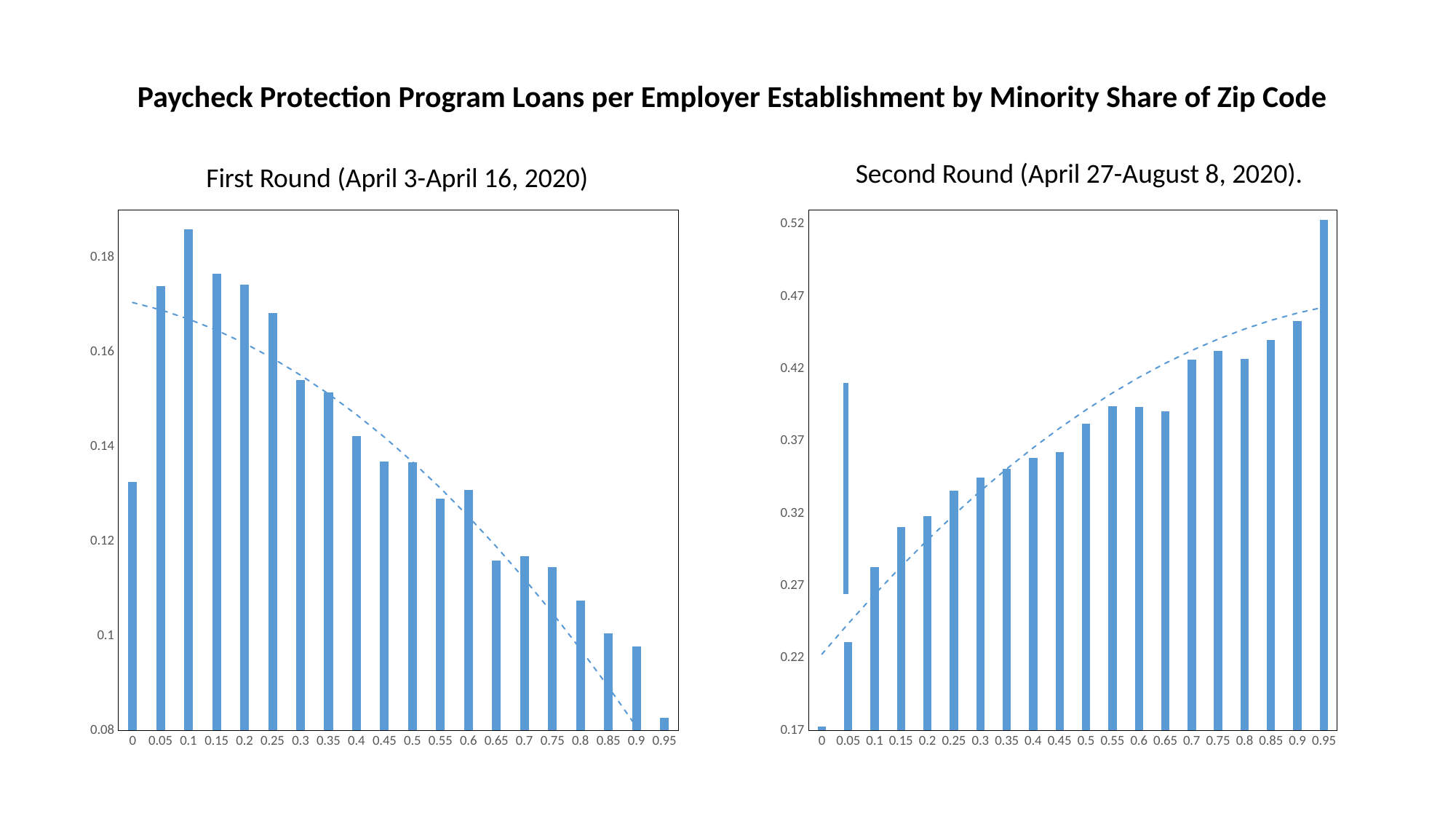
In the Second Round (April 27-August 8, 2020) chart, which minority share category has the highest value? 0.95 In the Second Round (April 27-August 8, 2020) chart, do the values generally rise or fall as the minority share increases along the x axis? rise In the First Round (April 3-April 16, 2020) chart, which minority share category has the lowest value? 0.95 In the Second Round (April 27-August 8, 2020) chart, is the value for 0.9 greater or less than 0.42? greater In the First Round (April 3-April 16, 2020) chart, is the value for 0.5 greater or less than 0.14? less In the First Round (April 3-April 16, 2020) chart, is the value for 0 greater or less than 0.12? greater In the First Round (April 3-April 16, 2020) chart, do the values generally rise or fall as the minority share increases along the x axis? fall In the First Round (April 3-April 16, 2020) chart, which minority share category has the highest value? 0.1 In the Second Round (April 27-August 8, 2020) chart, which minority share category has the lowest value? 0 What kind of chart is the First Round (April 3-April 16, 2020) chart? bar chart How many bars are plotted in the First Round (April 3-April 16, 2020) chart? 20 How many bars are plotted in the Second Round (April 27-August 8, 2020) chart? 20